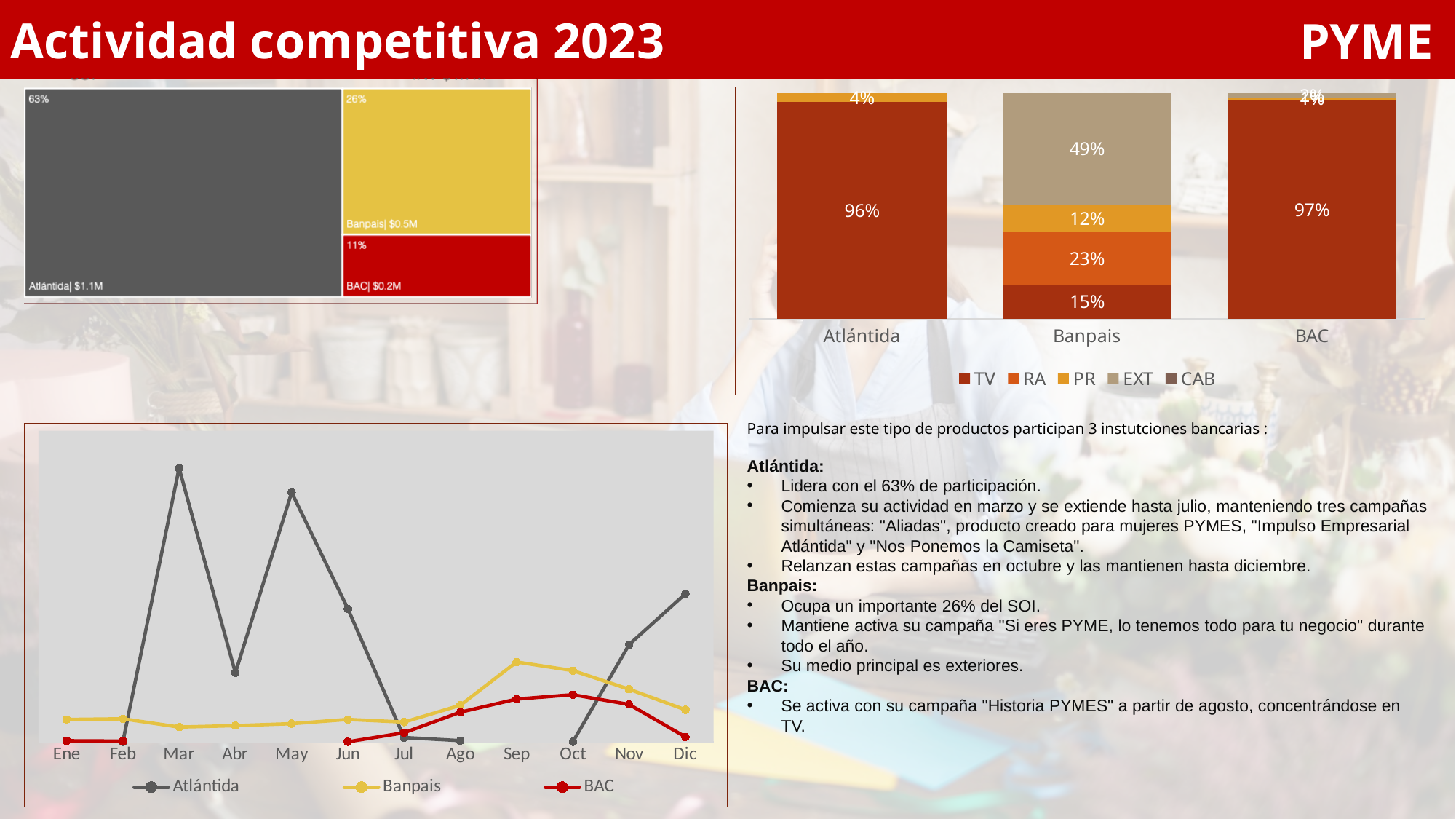
In the stacked bar chart at the top right, what percentage of Banpais's activity is RA? 23% What kind of chart is shown at the bottom left of the slide? Line chart In the treemap chart at the top left, which bank has the smallest share? BAC In the treemap chart at the top left, what is the difference in percentage points between Atlántida's and Banpais's shares? 37 In the line chart at the bottom left, how many months are shown on the x axis? 12 In the stacked bar chart at the top right, what percentage of Atlántida's activity is TV? 96% In the stacked bar chart at the top right, which bank has the highest TV share? BAC In the stacked bar chart at the top right, what percentage of Banpais's activity is EXT? 49% In the treemap chart at the top left, what share does Atlántida hold? 63% In the stacked bar chart at the top right, how many series does the legend list? 5 In the treemap chart at the top left, what dollar value is shown for Banpais? $0.5M